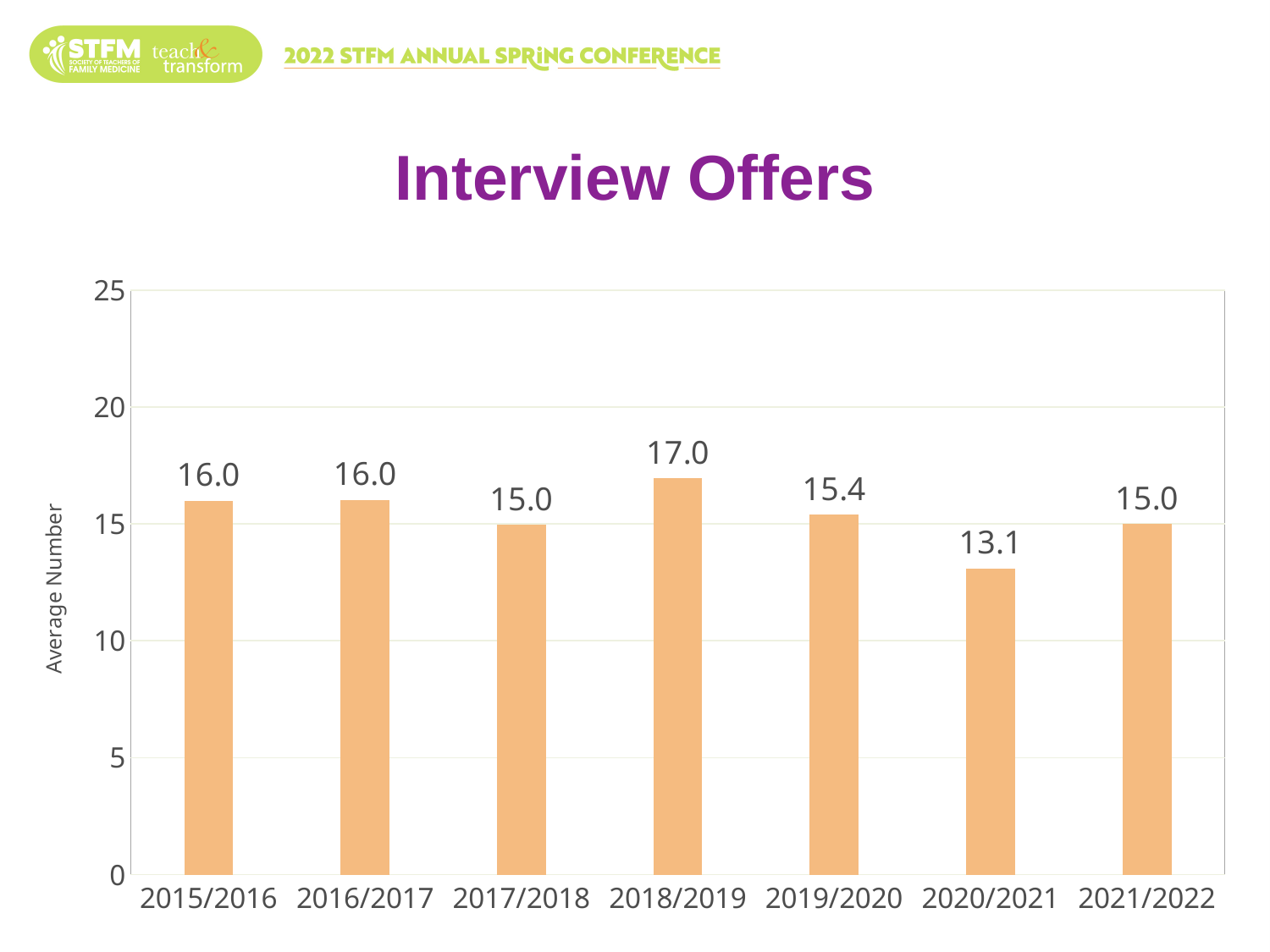
What is the average number of interview offers for 2018/2019? 17.0 What is the average number of interview offers for 2019/2020? 15.4 What is the label on the vertical axis? Average Number Which year has the lowest average number of interview offers? 2020/2021 Which year has a larger average number of interview offers, 2019/2020 or 2021/2022? 2019/2020 How many academic years are shown on the chart? 7 What kind of chart is shown on the slide? Bar chart What is the average number of interview offers for 2020/2021? 13.1 Which year has the highest average number of interview offers? 2018/2019 What is the difference between the average number of interview offers in 2018/2019 and 2020/2021? 3.9 What is the title of the chart? Interview Offers Is the value for 2020/2021 greater or less than 15? less